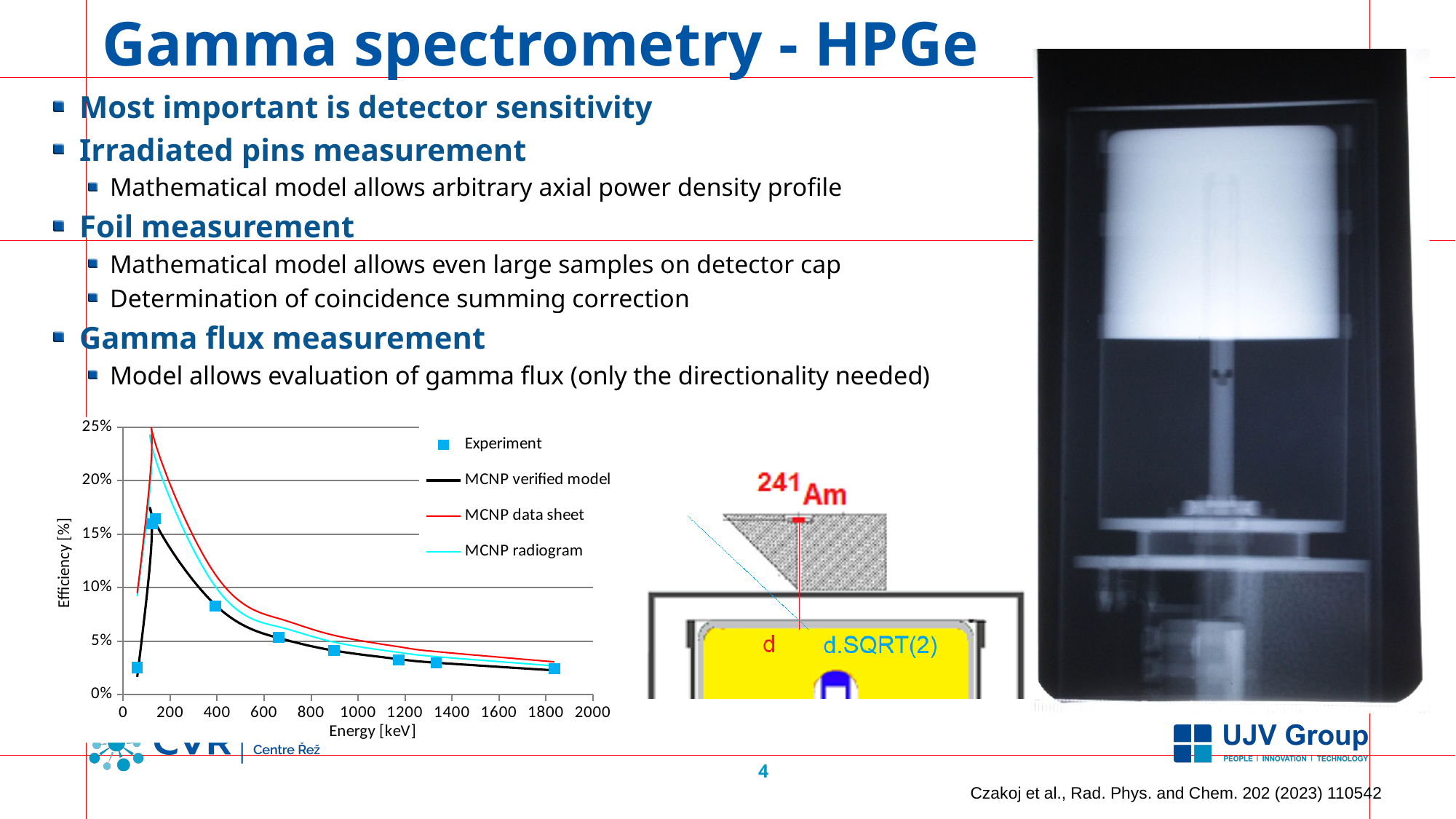
What is the label of the y axis of the efficiency chart? Efficiency [%] Beyond the peak near 100 keV, does the efficiency rise or fall as energy increases? fall Is the peak value of the MCNP verified model series greater or less than 15%? greater Is the peak value of the MCNP data sheet series greater or less than 20%? greater Which series has the lowest peak efficiency in the chart? MCNP verified model What is the label of the x axis of the efficiency chart? Energy [keV] What kind of chart is used to show efficiency versus energy? line chart Is the Experiment value at about 400 keV greater or less than 10%? less How many series does the legend of the efficiency chart list? 4 At about 400 keV, which series is higher: MCNP data sheet or MCNP verified model? MCNP data sheet Which series reaches the highest peak efficiency in the chart? MCNP data sheet